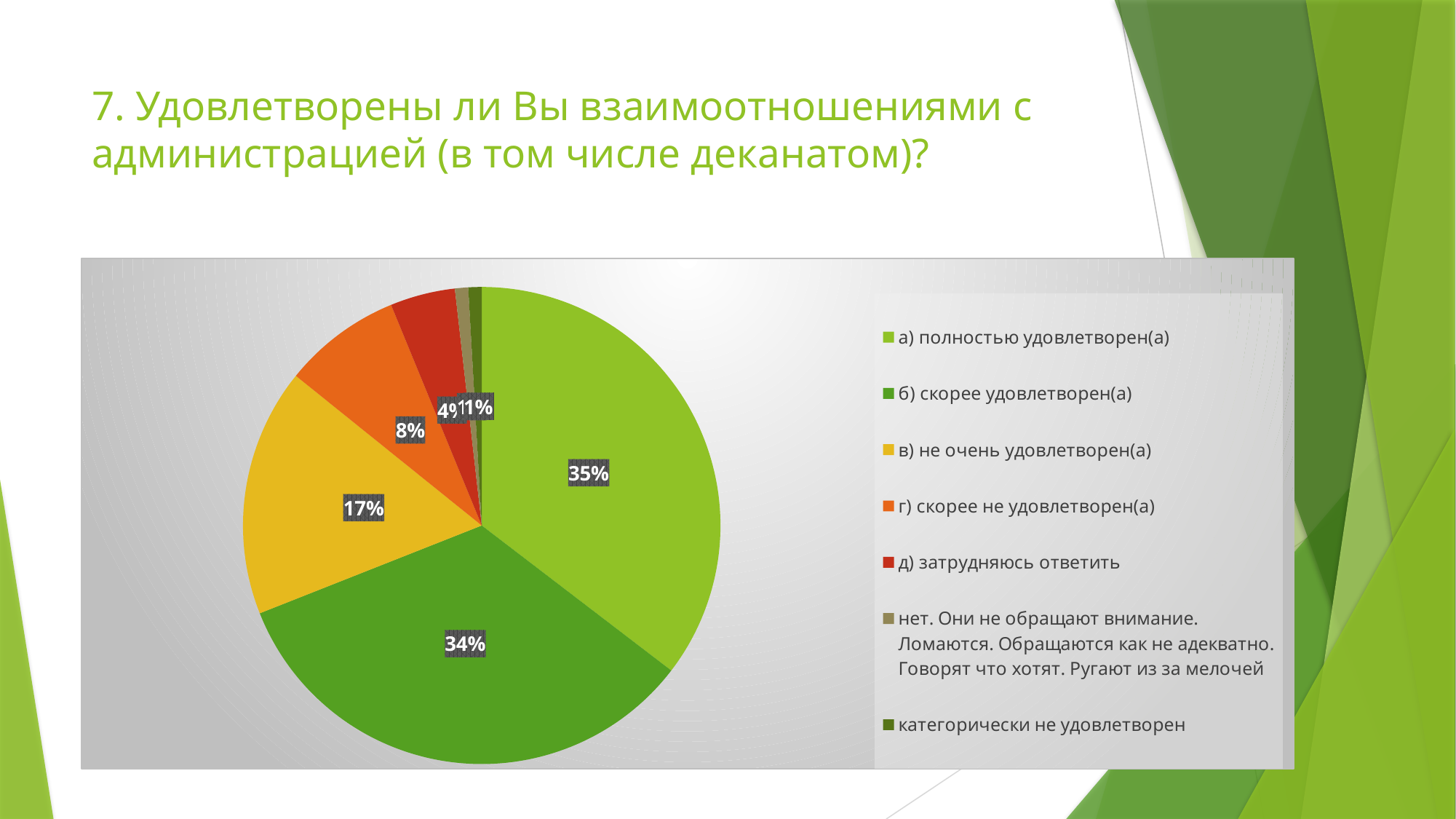
What share of the pie is labelled for "б) скорее удовлетворен(а)"? 34% Which category has the largest slice of the pie? а) полностью удовлетворен(а) What is the difference in percentage points between "а) полностью удовлетворен(а)" and "в) не очень удовлетворен(а)"? 18 What share of the pie is labelled for "в) не очень удовлетворен(а)"? 17% What share of the pie is labelled for "г) скорее не удовлетворен(а)"? 8% What kind of chart is shown on the slide? pie chart What is the difference in percentage points between "в) не очень удовлетворен(а)" and "г) скорее не удовлетворен(а)"? 9 What colour is the slice for "в) не очень удовлетворен(а)"? yellow What share of the pie is labelled for "а) полностью удовлетворен(а)"? 35% Which slice is larger: "в) не очень удовлетворен(а)" or "г) скорее не удовлетворен(а)"? в) не очень удовлетворен(а) What is the combined share of "а) полностью удовлетворен(а)" and "б) скорее удовлетворен(а)"? 69% How many categories does the legend list? 7